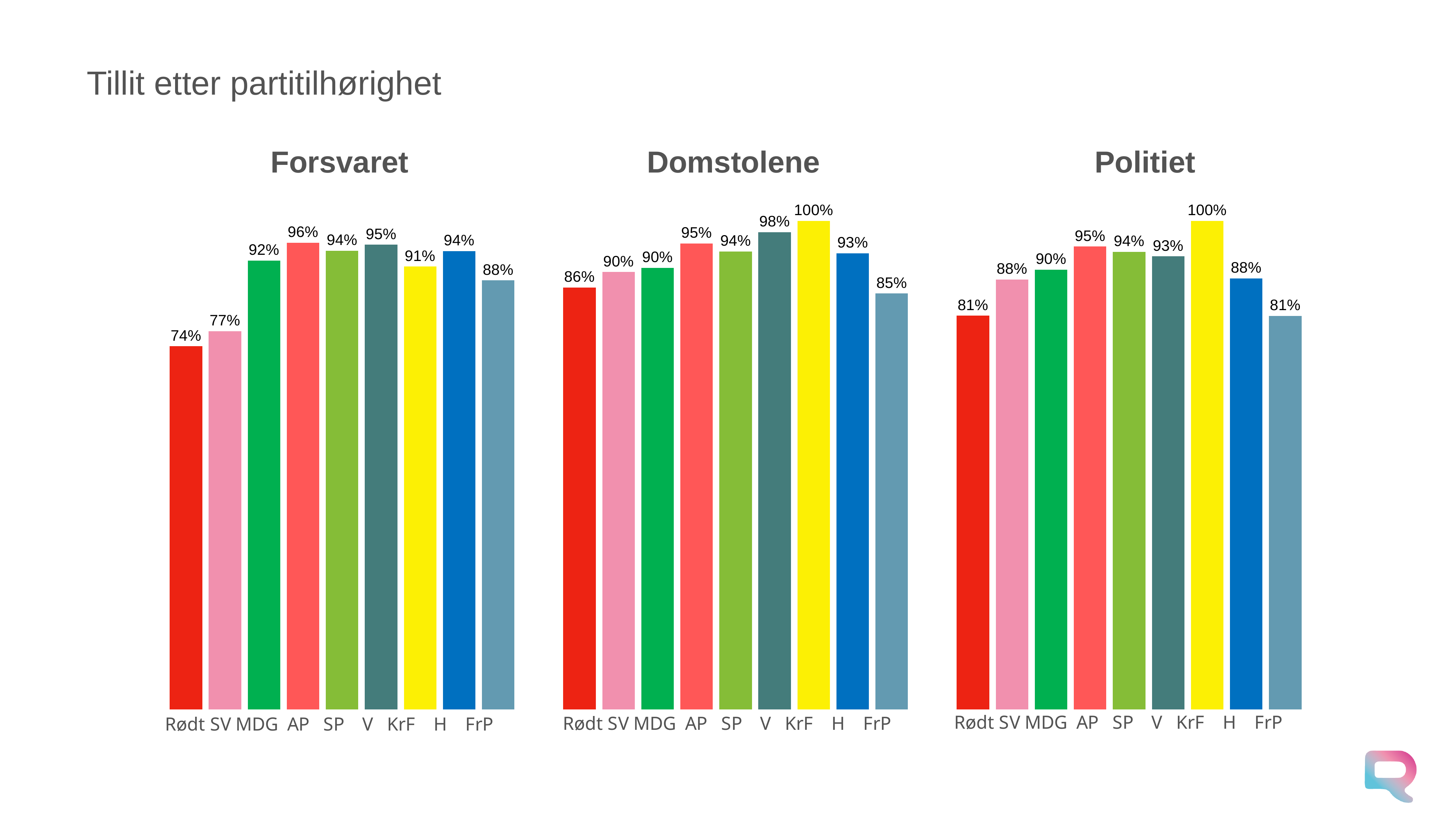
What is the title of the slide? Tillit etter partitilhørighet In the Politiet chart, which party has the highest value? KrF In the Domstolene chart, which party has the lowest value? FrP What kind of chart is the Domstolene chart? Bar chart In the Politiet chart, which is larger, the value for AP or the value for V? AP How many parties are shown in the Forsvaret chart? 9 In the Forsvaret chart, which party has the highest value? AP In the Forsvaret chart, which party has the lowest value? Rødt In the Forsvaret chart, what is the value for Rødt? 74% In the Domstolene chart, what is the value for KrF? 100% In the Domstolene chart, what is the difference between the values for KrF and Rødt? 14% In the Politiet chart, what is the value for H? 88%